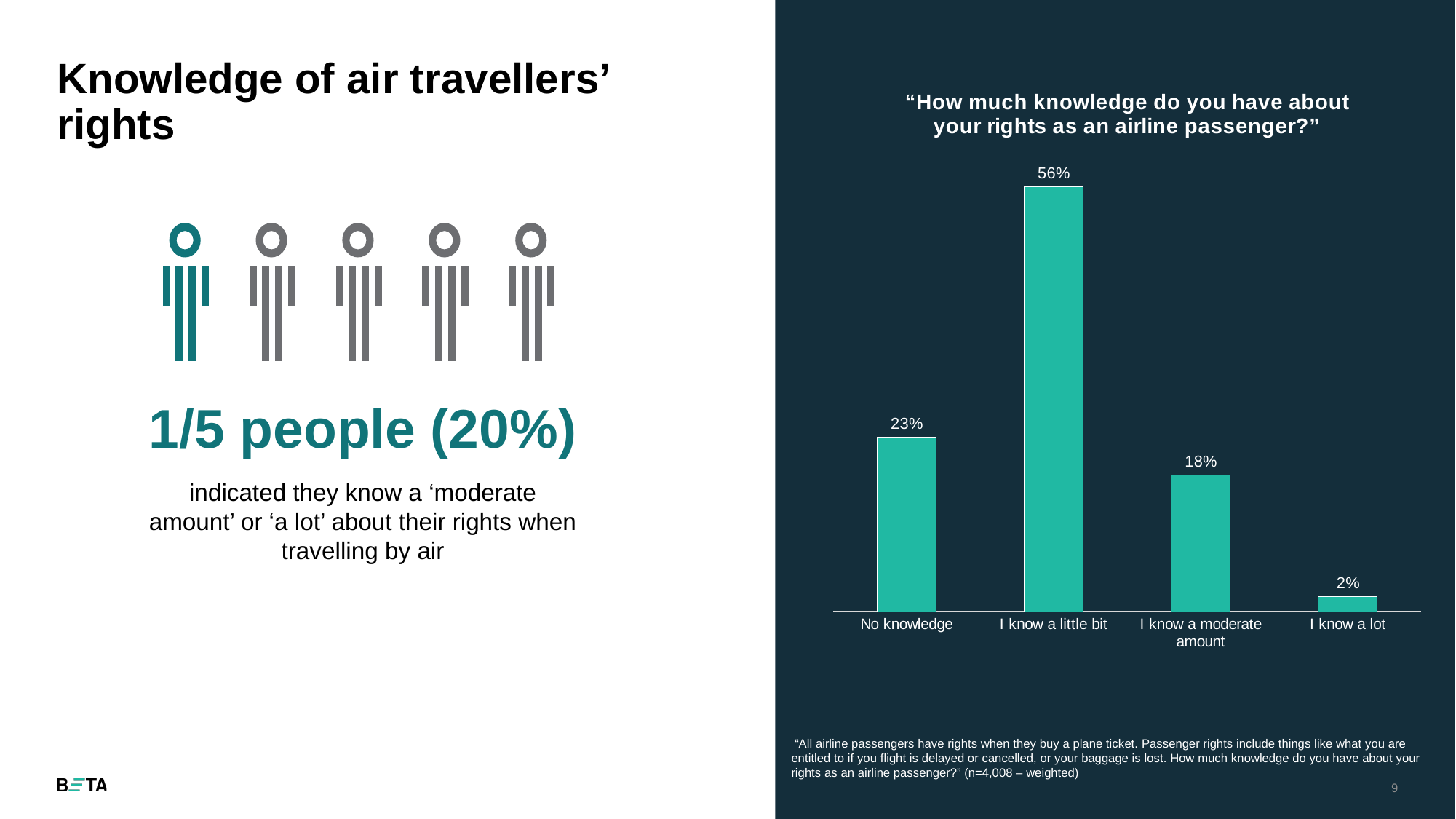
What is the difference between 'I know a little bit' and 'No knowledge'? 33% What is the value for 'I know a lot'? 2% What is the difference between 'No knowledge' and 'I know a moderate amount'? 5% What is the title of the chart? "How much knowledge do you have about your rights as an airline passenger?" Which category has the highest value? I know a little bit Which category has the lowest value? I know a lot What percentage of respondents said they have no knowledge of their rights as an airline passenger? 23% What percentage of respondents said 'I know a moderate amount'? 18% What kind of chart is shown on the slide? Bar chart How many categories are shown on the chart? 4 What is the value for 'I know a little bit'? 56% Which is larger, 'No knowledge' or 'I know a moderate amount'? No knowledge